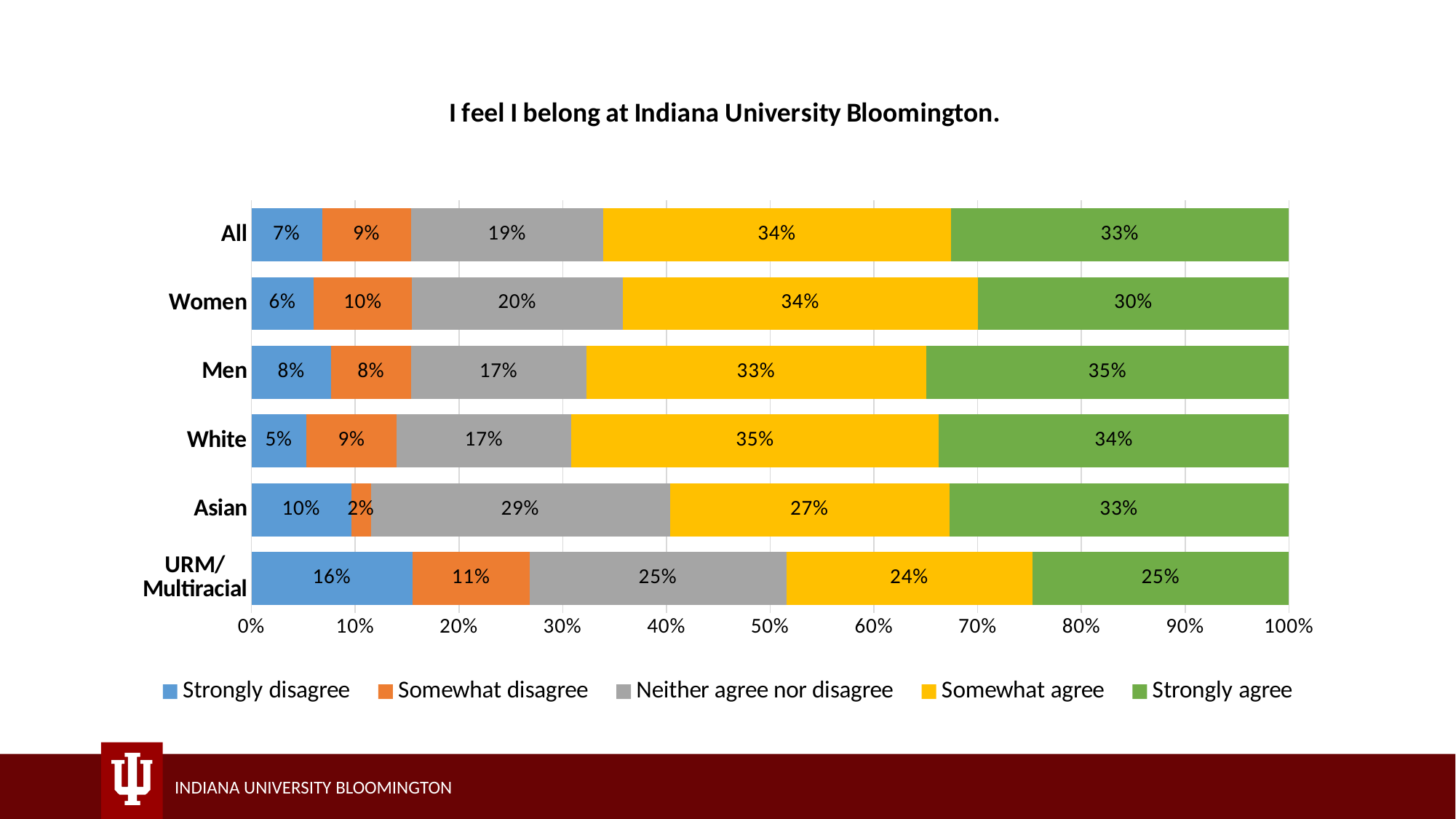
How many groups (categories) are shown on the chart? 6 What is the combined percentage of 'Somewhat agree' and 'Strongly agree' for the All group? 67% What is the title of the chart? I feel I belong at Indiana University Bloomington. Which group has the highest 'Strongly disagree' percentage? URM/Multiracial What is the 'Neither agree nor disagree' value for the Asian group? 29% What is the difference between the 'Strongly agree' percentages for Men and URM/Multiracial? 10% What percentage of the URM/Multiracial group strongly disagree? 16% Which is larger: the 'Somewhat agree' value for White or for Asian? White Which group has the lowest 'Somewhat disagree' percentage? Asian How many series does the legend list? 5 What kind of chart is shown on the slide? Stacked bar chart What percentage of Women strongly agree that they feel they belong at Indiana University Bloomington? 30%